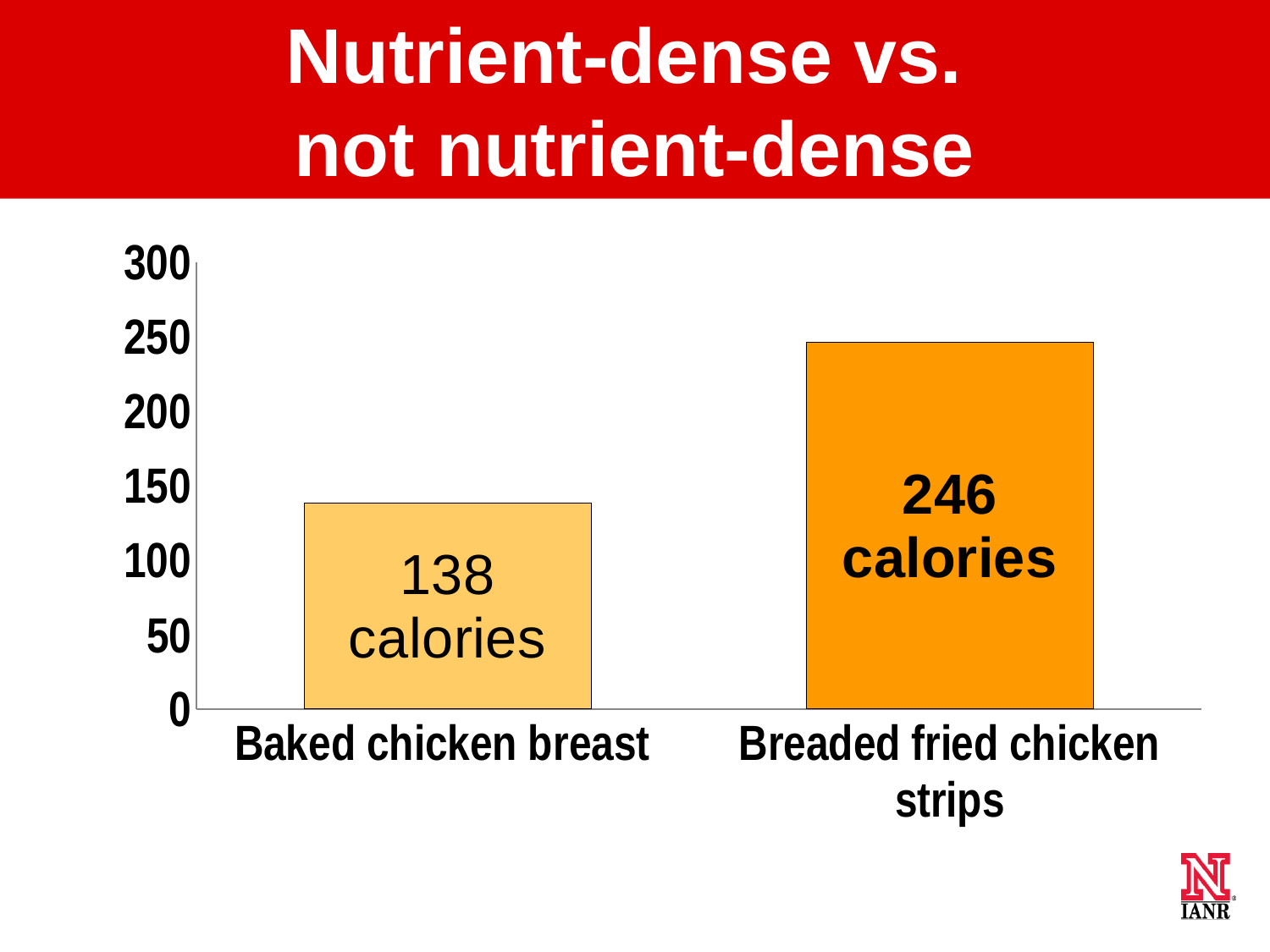
What kind of chart is shown on the slide? Bar chart Which category has the highest calorie value? Breaded fried chicken strips Is the value for Breaded fried chicken strips greater or less than 200? greater How many calories does the chart show for Baked chicken breast? 138 calories How many categories are shown on the chart? 2 Which has more calories, Baked chicken breast or Breaded fried chicken strips? Breaded fried chicken strips Is the value for Baked chicken breast greater or less than 150? less What is the title of the slide? Nutrient-dense vs. not nutrient-dense How many calories does the chart show for Breaded fried chicken strips? 246 calories What is the difference in calories between Breaded fried chicken strips and Baked chicken breast? 108 calories Which category has the lowest calorie value? Baked chicken breast What is the highest value shown on the vertical axis? 300